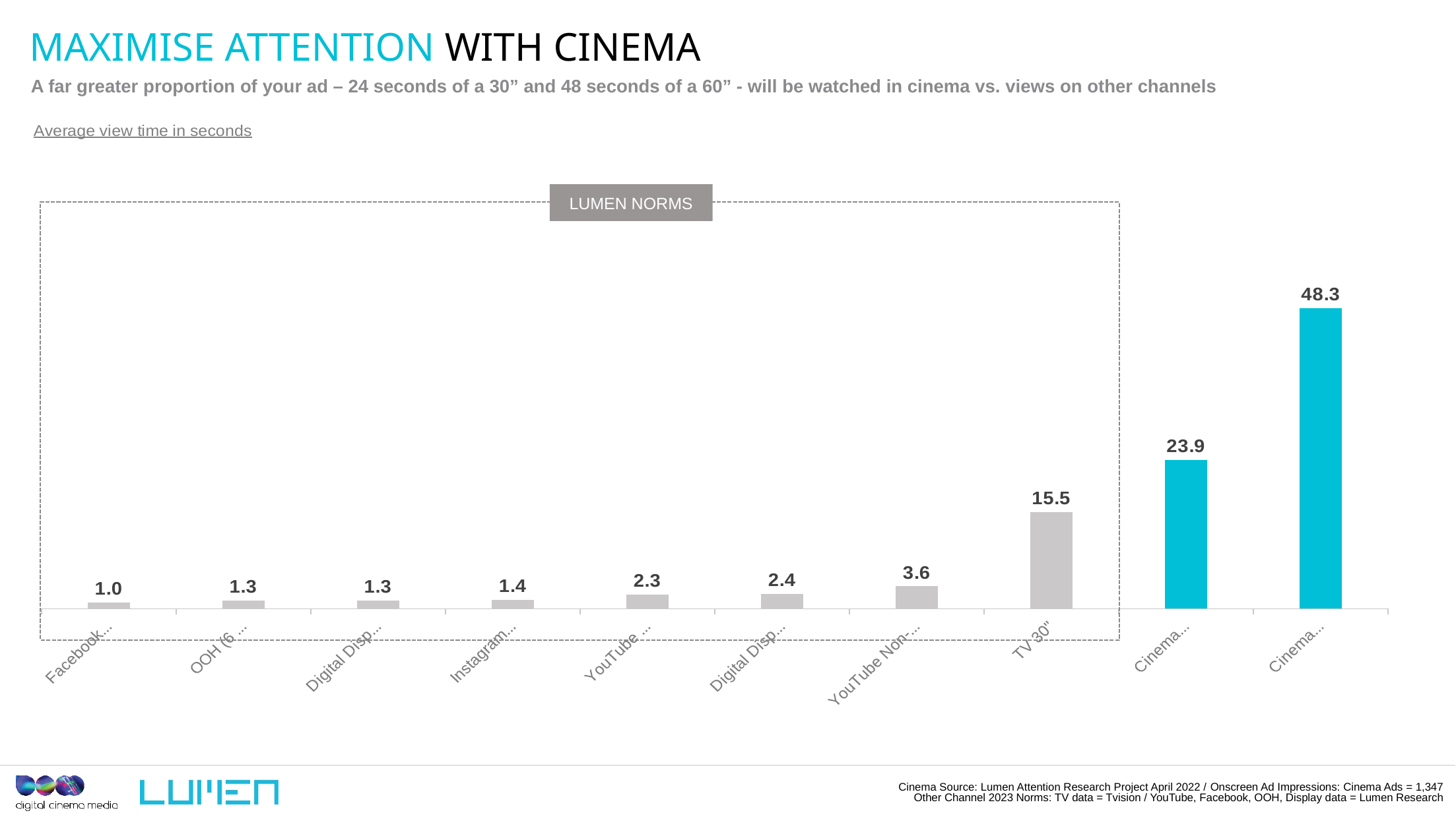
What is the value shown for the Instagram bar? 1.4 What does the grey label above the dashed box in the chart say? LUMEN NORMS Which category has the lowest average view time? Facebook What is the average view time in seconds for TV 30"? 15.5 How many bars are plotted in the chart? 10 How much higher is the first Cinema bar (23.9) than the TV 30" bar? 8.4 What kind of chart is shown on the slide? bar chart Which is larger, the value for TV 30" or the value for YouTube Non-...? TV 30" What is the difference between the two Cinema bars (48.3 and 23.9)? 24.4 What is the value shown for the YouTube Non-... bar? 3.6 What is the value of the first (leftmost) bar, Facebook? 1.0 What is the highest value shown in the chart? 48.3